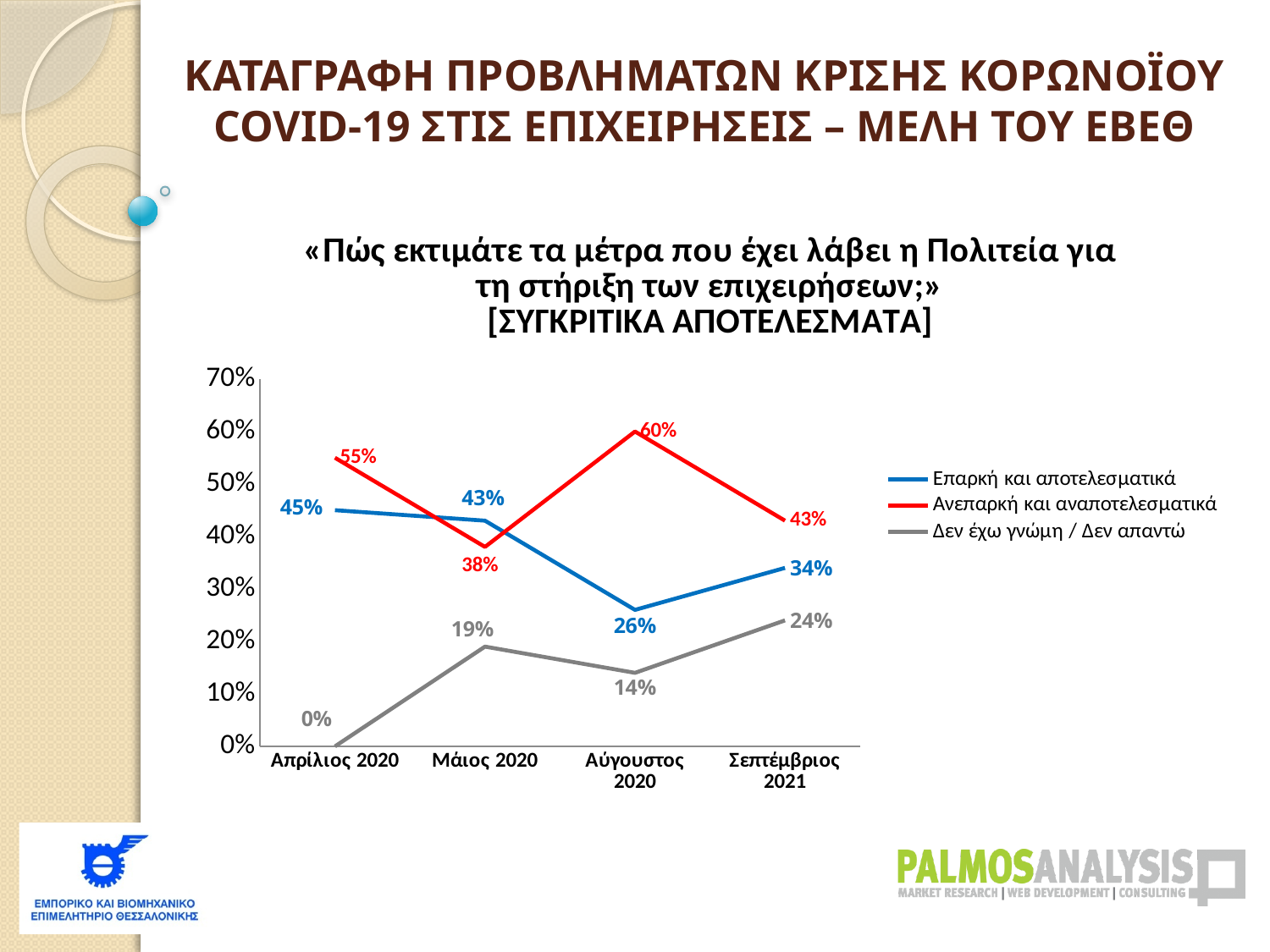
What is the difference between «Ανεπαρκή και αναποτελεσματικά» and «Επαρκή και αποτελεσματικά» in Αύγουστος 2020? 34 percentage points In which period is «Επαρκή και αποτελεσματικά» at its lowest? Αύγουστος 2020 How does «Δεν έχω γνώμη / Δεν απαντώ» change from Αύγουστος 2020 to Σεπτέμβριος 2021? It rises In which period is «Ανεπαρκή και αναποτελεσματικά» at its highest? Αύγουστος 2020 What is the value for «Ανεπαρκή και αναποτελεσματικά» in Αύγουστος 2020? 60% What is the value for «Επαρκή και αποτελεσματικά» in Απρίλιος 2020? 45% Which colour is used for the «Ανεπαρκή και αναποτελεσματικά» line? Red How many time points are shown on the x axis? 4 What kind of chart is shown on the slide? Line chart In Μάιος 2020, which is larger: «Επαρκή και αποτελεσματικά» or «Ανεπαρκή και αναποτελεσματικά»? Επαρκή και αποτελεσματικά How many series does the legend list? 3 What is the value for «Δεν έχω γνώμη / Δεν απαντώ» in Σεπτέμβριος 2021? 24%